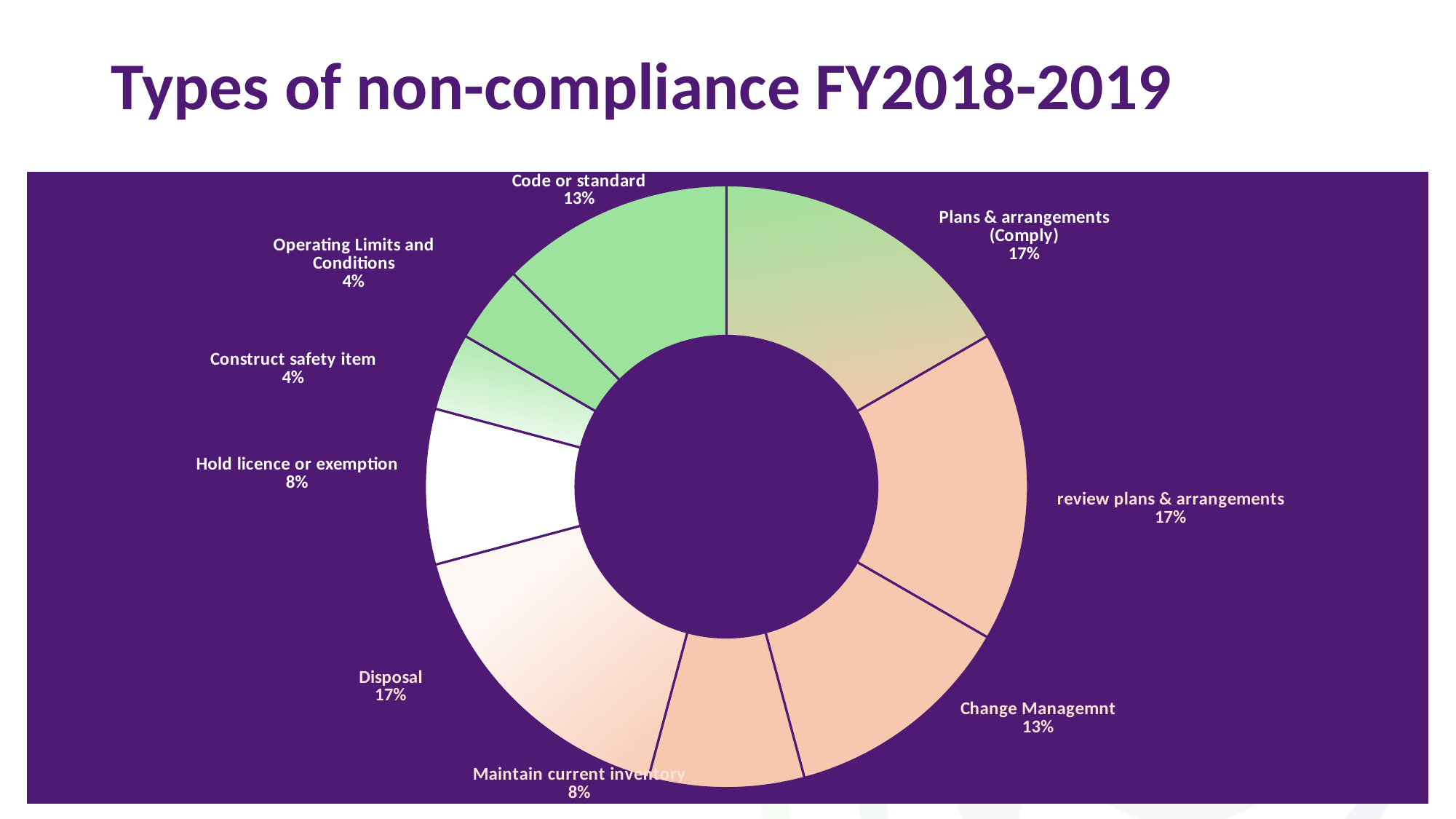
Which is larger, Disposal or Code or standard? Disposal What is the difference in percentage points between review plans & arrangements and Change Managemnt? 4 What kind of chart is shown on the slide? doughnut chart What is the value shown for Hold licence or exemption? 8% What share does Code or standard have in the chart? 13% What percentage of non-compliance is attributed to Disposal? 17% What is the value for Change Managemnt? 13% What percentage is shown for Construct safety item? 4% What percentage is shown for Maintain current inventory? 8% What is the difference in percentage points between Plans & arrangements (Comply) and Construct safety item? 13 How many categories are shown in the chart? 9 Which is larger, Hold licence or exemption or Operating Limits and Conditions? Hold licence or exemption